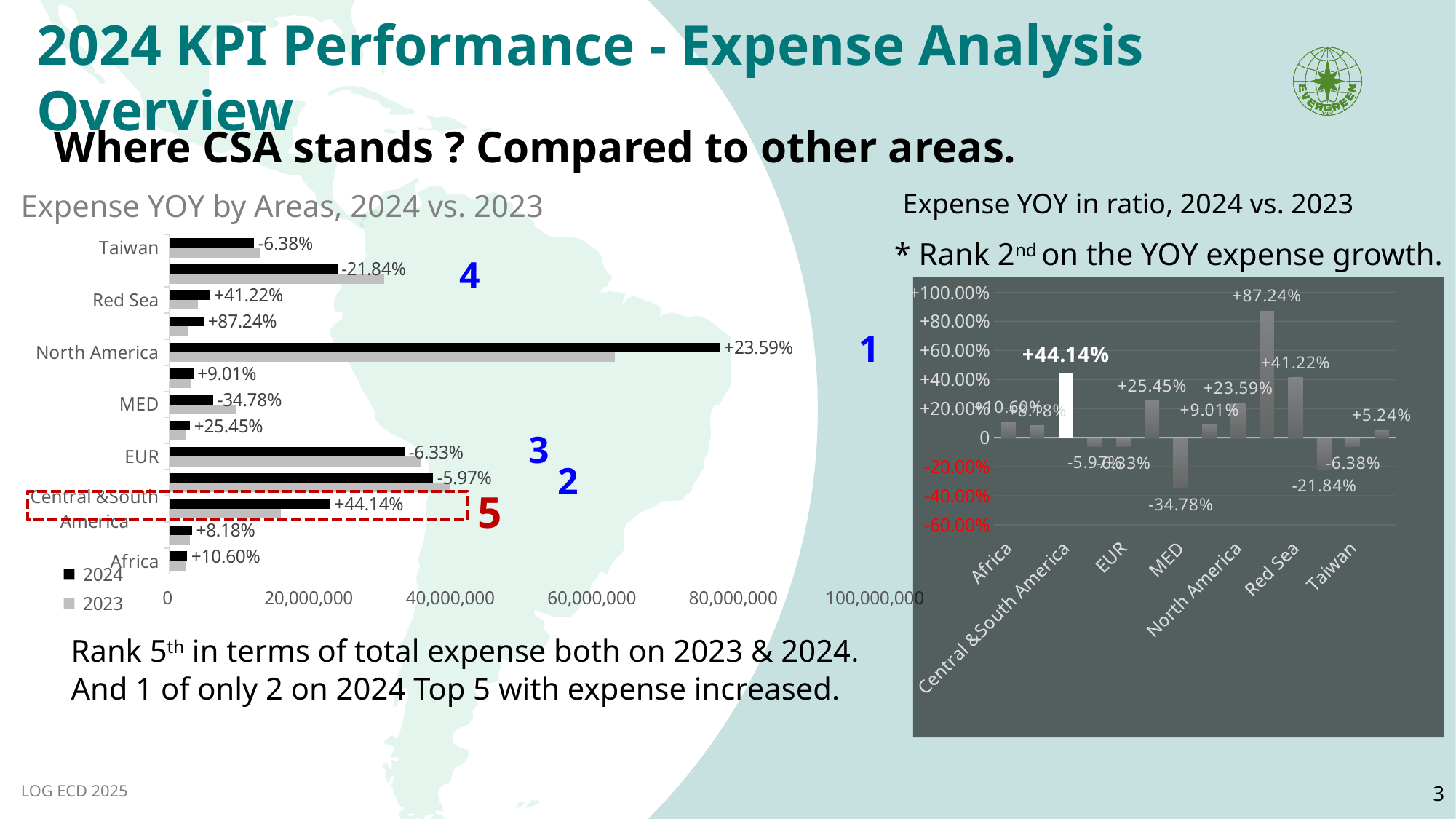
What type of chart is the 'Expense YOY in ratio, 2024 vs. 2023' chart on the right? Bar chart In the left chart 'Expense YOY by Areas, 2024 vs. 2023', which area has the longest 2024 bar? North America What type of chart is the 'Expense YOY by Areas, 2024 vs. 2023' chart on the left? Bar chart In the left chart 'Expense YOY by Areas, 2024 vs. 2023', what is the YOY percentage label on the longest North America bar? +23.59% In the right chart 'Expense YOY in ratio, 2024 vs. 2023', how many area labels are shown on the x axis? 7 In the left chart 'Expense YOY by Areas, 2024 vs. 2023', how many series does the legend list? 2 In the left chart 'Expense YOY by Areas, 2024 vs. 2023', what are the two legend entries? 2024 and 2023 In the right chart 'Expense YOY in ratio, 2024 vs. 2023', what is the highest value shown? +87.24% In the left chart 'Expense YOY by Areas, 2024 vs. 2023', is the 2024 bar for North America greater or less than 60,000,000? greater In the right chart 'Expense YOY in ratio, 2024 vs. 2023', what is the value of the highlighted white bar for Central & South America? +44.14% In the right chart 'Expense YOY in ratio, 2024 vs. 2023', what is the difference between the highest value (+87.24%) and the value +41.22%? 46.02 percentage points In the right chart 'Expense YOY in ratio, 2024 vs. 2023', what is the lowest value shown? -34.78%